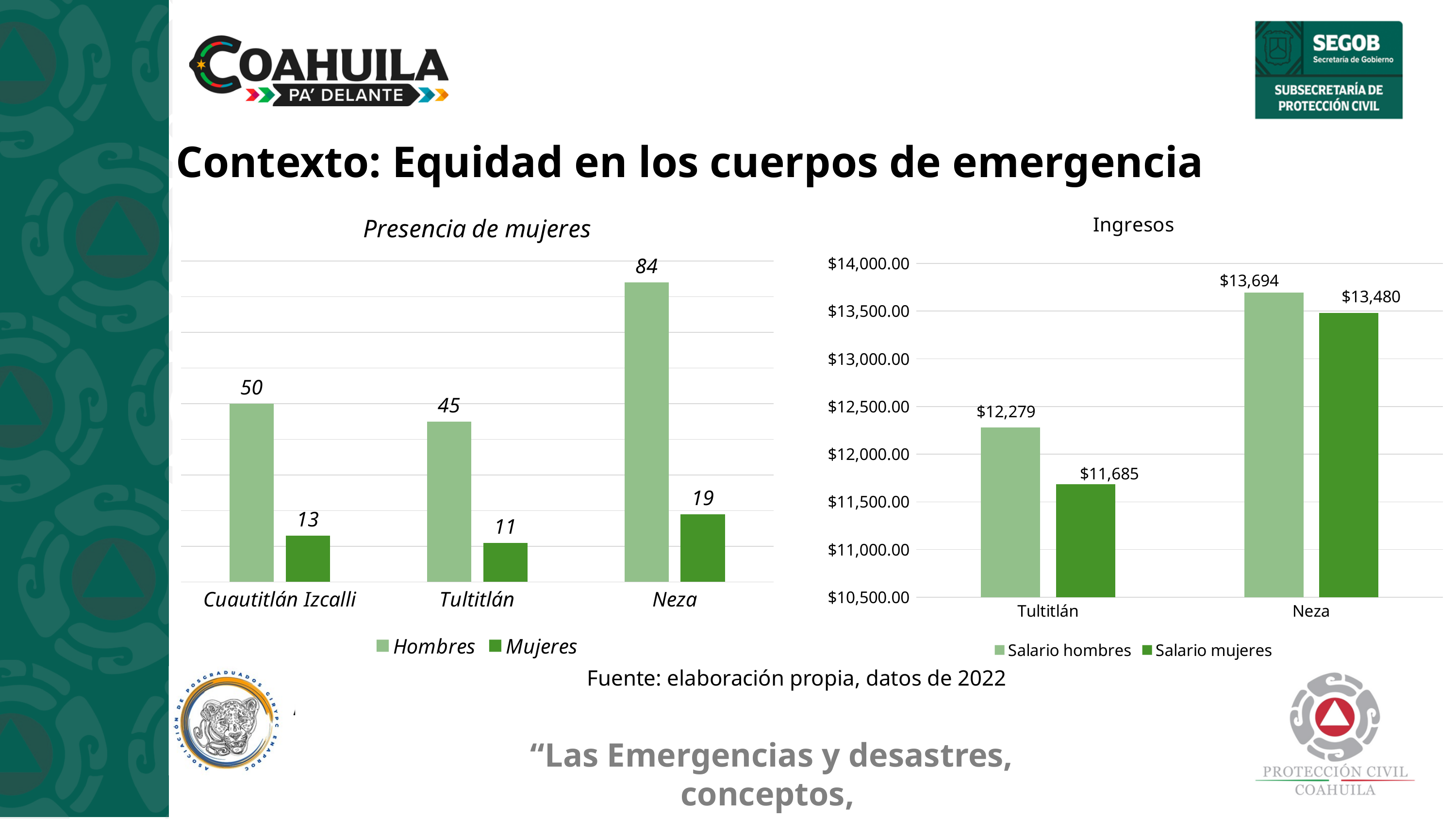
In the 'Ingresos' chart, what is the Salario mujeres value for Neza? $13,480 What kind of chart is the 'Ingresos' chart? Bar chart In the 'Ingresos' chart, what is the Salario hombres value for Tultitlán? $12,279 In the 'Presencia de mujeres' chart, how many categories are shown on the x axis? 3 In the 'Ingresos' chart, which is larger: Salario mujeres in Neza or Salario hombres in Tultitlán? Salario mujeres in Neza In the 'Ingresos' chart, what is the difference between Salario hombres and Salario mujeres in Tultitlán? $593 In the 'Presencia de mujeres' chart, what is the value for Hombres in Neza? 84 In the 'Presencia de mujeres' chart, which category has the highest Mujeres value? Neza In the 'Presencia de mujeres' chart, which category has the lowest Hombres value? Tultitlán In the 'Ingresos' chart, how many series does the legend list? 2 In the 'Presencia de mujeres' chart, what is the value for Mujeres in Tultitlán? 11 In the 'Presencia de mujeres' chart, what is the difference between Hombres and Mujeres in Cuautitlán Izcalli? 37